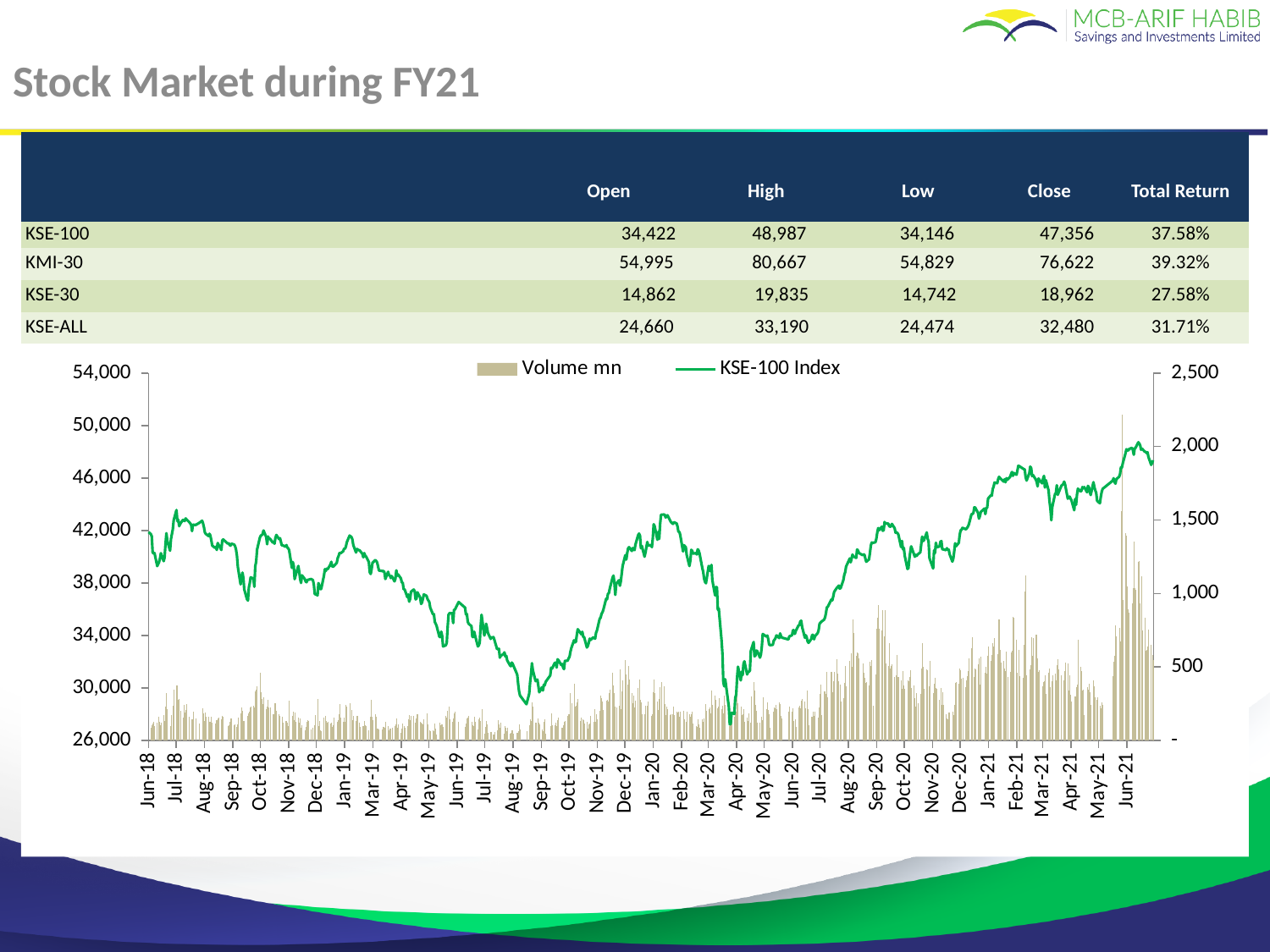
Are the Volume mn bars generally taller in 2021 or in 2018? 2021 Does the KSE-100 Index line generally rise or fall from Jun-18 to Aug-19? fall Is the lowest point of the KSE-100 Index line, around Mar-20 to Apr-20, greater or less than 30,000? less Does the KSE-100 Index line generally rise or fall from Apr-20 to Jun-21? rise Is the KSE-100 Index at the start of the chart in Jun-18 greater or less than 38,000? greater Is the KSE-100 Index higher in Jun-21 or in Aug-19? Jun-21 Is the KSE-100 Index at the end of Jun-21 greater or less than 46,000? greater Which series is drawn as a line in the chart? KSE-100 Index What kind of chart is shown below the table? A combined bar and line chart How many series does the chart legend list? 2 What are the two series named in the chart legend? Volume mn and KSE-100 Index